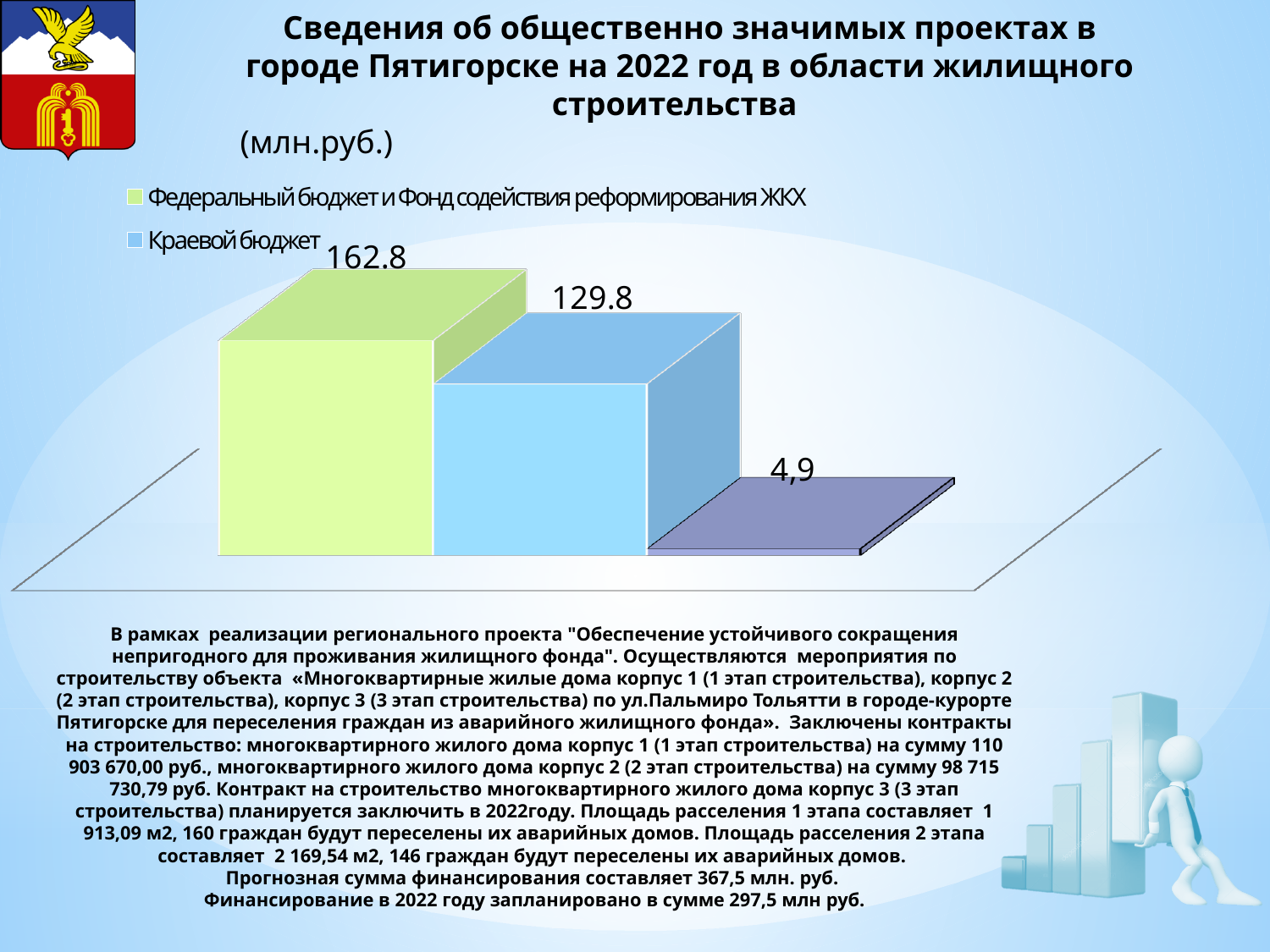
How many bars are plotted on the chart? 3 How many entries does the legend list? 2 What is the smallest value shown on the chart? 4,9 What is the difference between the values for Федеральный бюджет и Фонд содействия реформирования ЖКХ and Краевой бюджет? 33 What is the value for Федеральный бюджет и Фонд содействия реформирования ЖКХ? 162.8 What value is labelled on the smallest (purple) bar on the right? 4,9 In what units are the chart values given? млн.руб. Which legend entry has the highest value? Федеральный бюджет и Фонд содействия реформирования ЖКХ What is the value for Краевой бюджет? 129.8 What is the sum of the three values shown on the chart? 297.5 What kind of chart is shown on the slide? bar chart Which is larger: Федеральный бюджет и Фонд содействия реформирования ЖКХ or Краевой бюджет? Федеральный бюджет и Фонд содействия реформирования ЖКХ